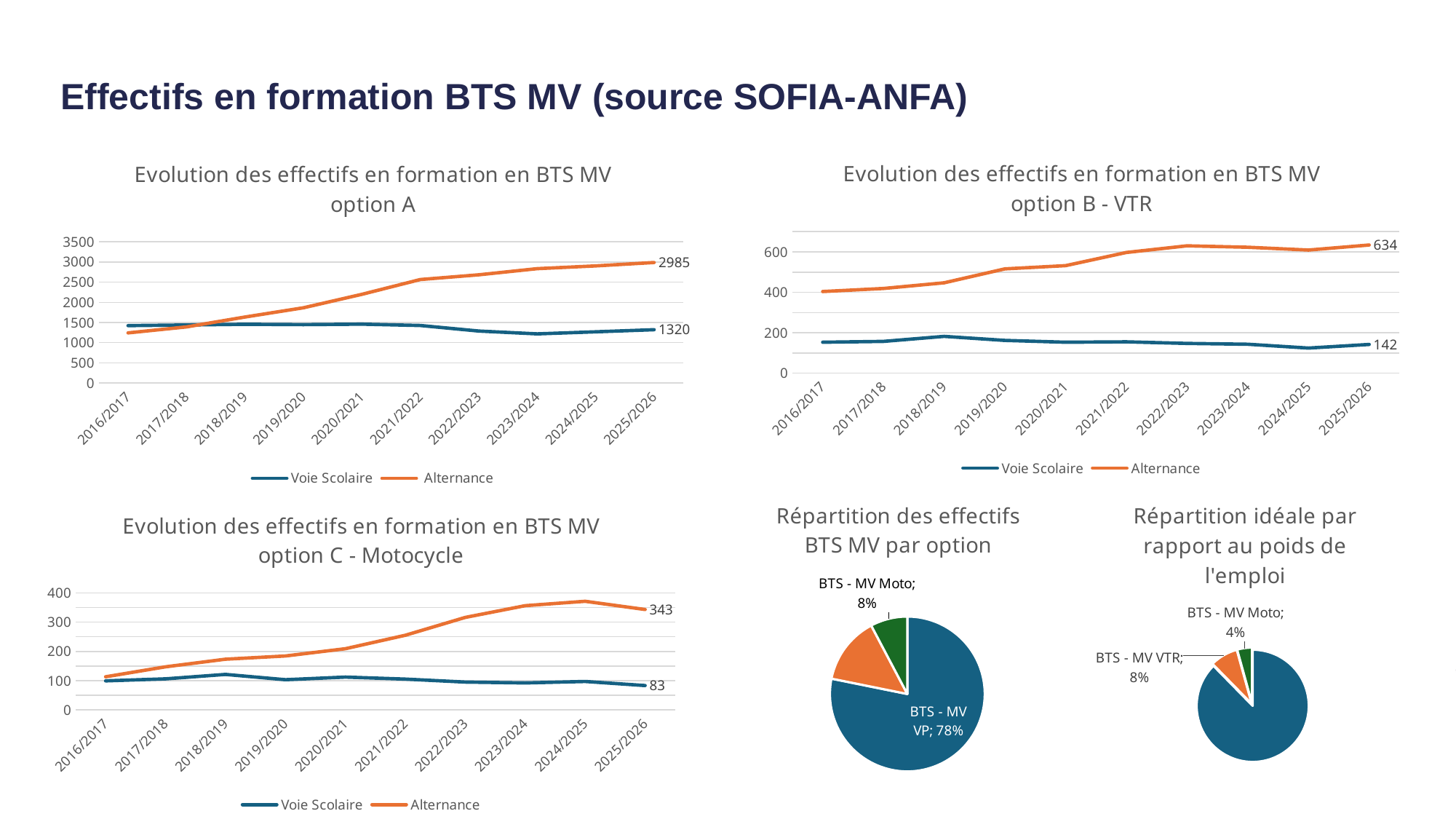
On the chart 'Evolution des effectifs en formation en BTS MV option A', is the value for Voie Scolaire in 2023/2024 greater or less than 1500? less On the chart 'Evolution des effectifs en formation en BTS MV option A', what is the value for Voie Scolaire in 2025/2026? 1320 On the chart 'Evolution des effectifs en formation en BTS MV option A', what is the value for Alternance in 2025/2026? 2985 On the chart 'Evolution des effectifs en formation en BTS MV option A', what is the difference between Alternance and Voie Scolaire in 2025/2026? 1665 What kind of chart is 'Evolution des effectifs en formation en BTS MV option C - Motocycle'? line chart On the chart 'Evolution des effectifs en formation en BTS MV option B - VTR', what is the value for Alternance in 2025/2026? 634 On the chart 'Evolution des effectifs en formation en BTS MV option C - Motocycle', which series has the larger value in 2025/2026, Alternance or Voie Scolaire? Alternance On the pie chart 'Répartition des effectifs BTS MV par option', what share does BTS - MV VP have? 78% On the chart 'Evolution des effectifs en formation en BTS MV option A', does the Alternance series rise or fall from 2016/2017 to 2025/2026? rises On the chart 'Evolution des effectifs en formation en BTS MV option B - VTR', what is the difference between Alternance and Voie Scolaire in 2025/2026? 492 On the chart 'Evolution des effectifs en formation en BTS MV option C - Motocycle', what is the value for Voie Scolaire in 2025/2026? 83 How many school years are shown on the x axis of the chart 'Evolution des effectifs en formation en BTS MV option B - VTR'? 10